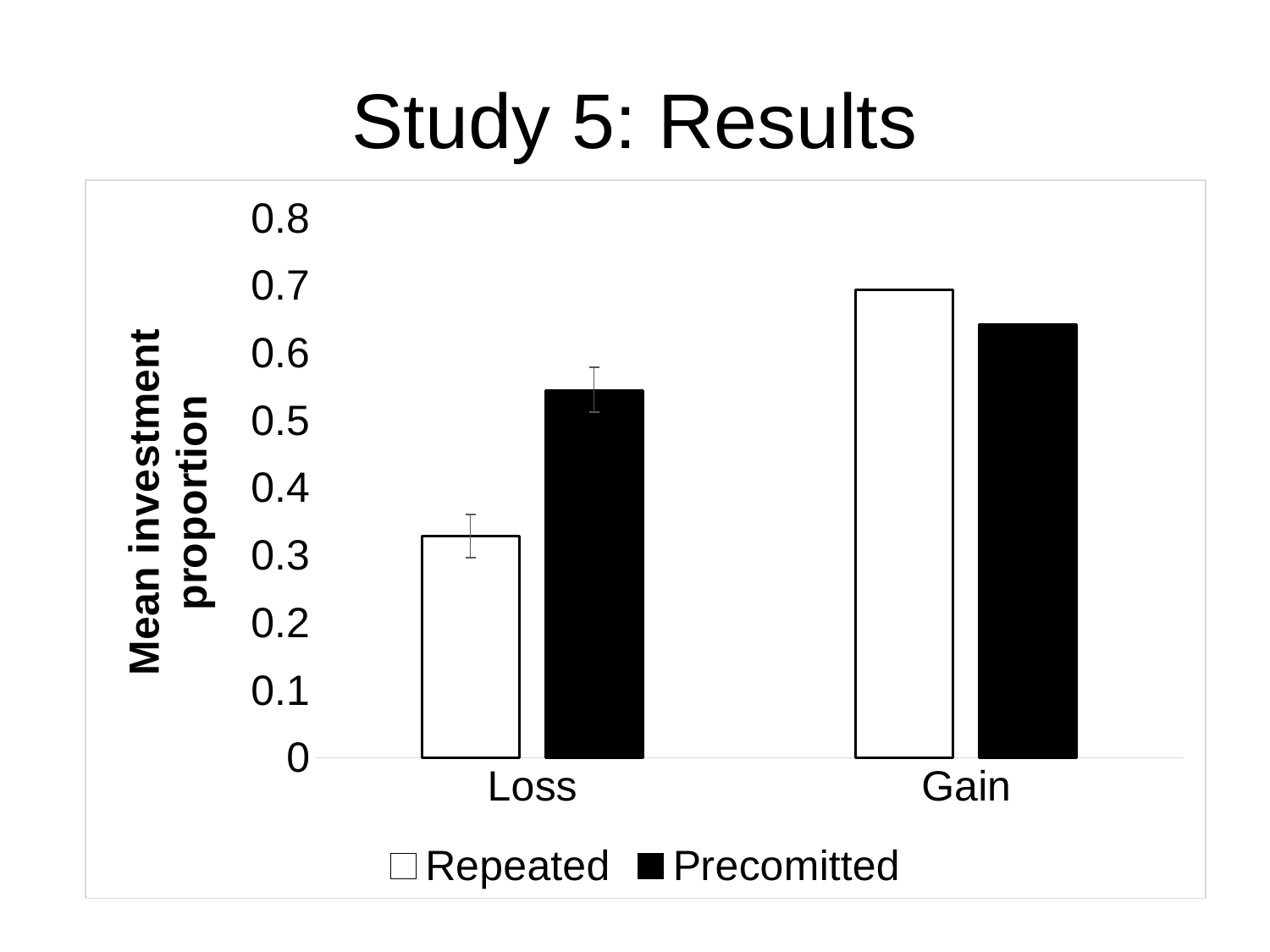
How many categories are shown on the x axis? 2 Is the Precomitted value for Loss greater or less than 0.5? greater What is the label of the vertical axis? Mean investment proportion Which series is shown with black bars? Precomitted For the Loss condition, which series has the larger value, Repeated or Precomitted? Precomitted What kind of chart is shown on the slide? bar chart Is the Repeated value for Gain greater or less than 0.6? greater Which bar has the lowest value in the chart? Repeated, Loss For the Gain condition, which series has the larger value, Repeated or Precomitted? Repeated How many series does the legend list? 2 Is the Repeated value for Loss greater or less than 0.4? less